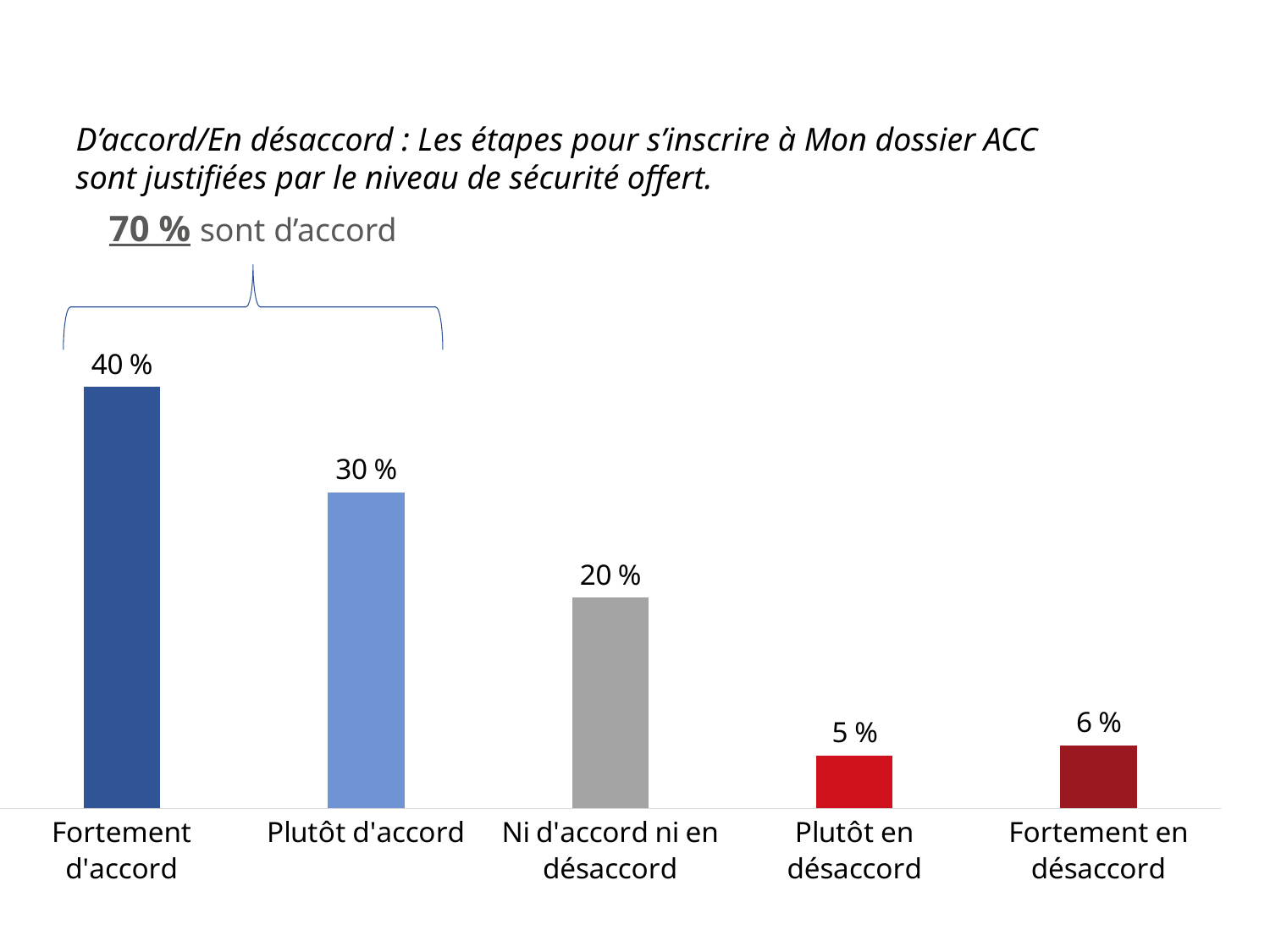
What is the difference between the values for "Fortement d'accord" and "Plutôt d'accord"? 10 % Which category has the highest value? Fortement d'accord What is the value for "Fortement d'accord"? 40 % What is the value for "Plutôt d'accord"? 30 % How many categories are shown on the chart? 5 What is the value for "Ni d'accord ni en désaccord"? 20 % What is the value for "Fortement en désaccord"? 6 % Which is larger, the value for "Ni d'accord ni en désaccord" or the value for "Fortement en désaccord"? Ni d'accord ni en désaccord What is the combined value of "Fortement d'accord" and "Plutôt d'accord"? 70 % What kind of chart is shown on the slide? Bar chart What percentage does the slide say are in agreement ("sont d'accord")? 70 % Which category has the lowest value? Plutôt en désaccord